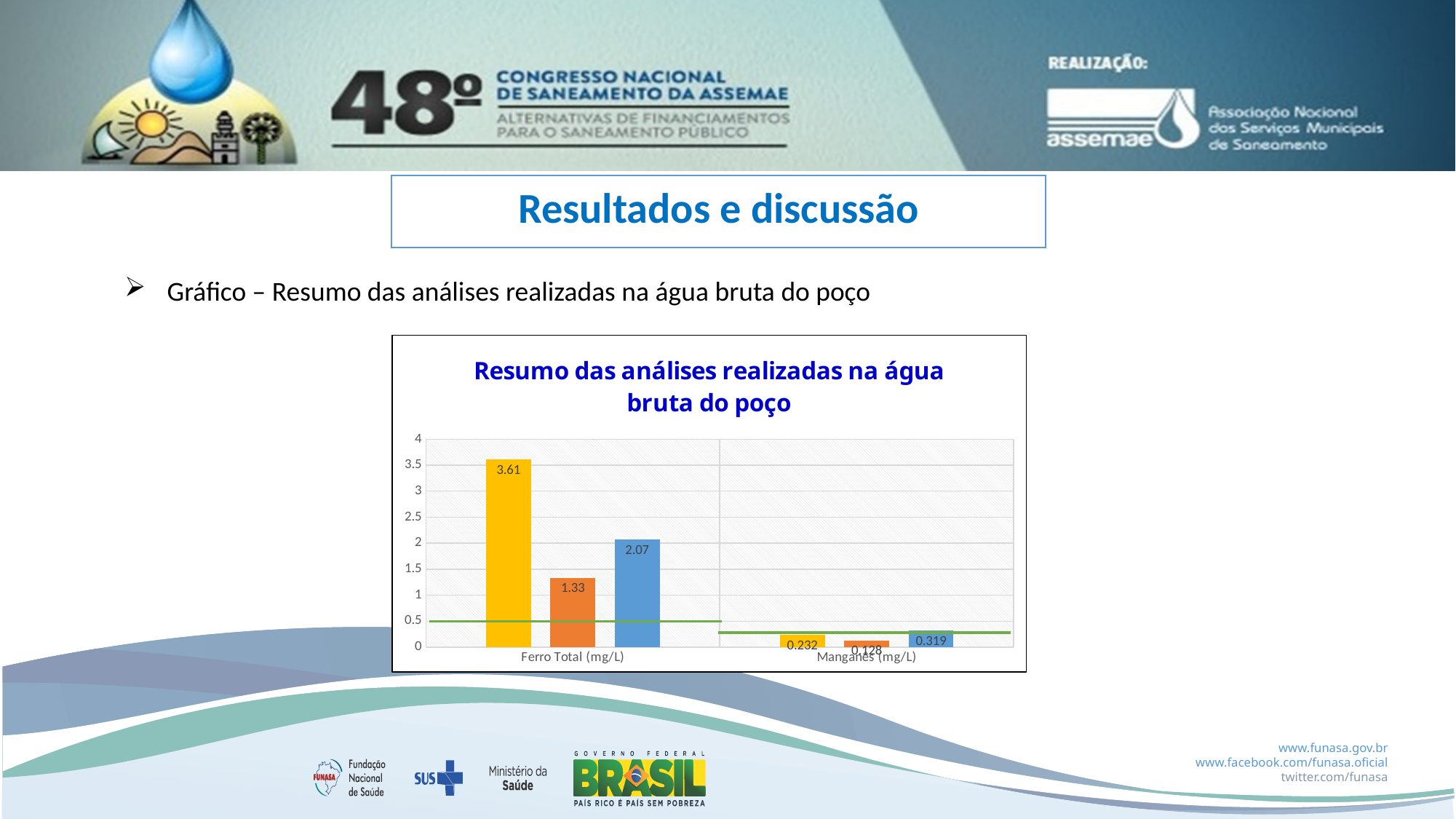
How many categories are shown on the x axis of the chart? 2 Which bar has the highest value in the Ferro Total (mg/L) category? The yellow bar (3.61) What is the value of the orange bar for Ferro Total (mg/L)? 1.33 What is the title of the chart? Resumo das análises realizadas na água bruta do poço What kind of chart is shown on the slide? Bar chart Which bar has the lowest value in the Manganês (mg/L) category? The orange bar (0.128) What is the value of the yellow bar for Ferro Total (mg/L)? 3.61 What is the value of the blue bar for Manganês (mg/L)? 0.319 What is the value of the yellow bar for Manganês (mg/L)? 0.232 What is the difference between the yellow bar and the blue bar for Ferro Total (mg/L)? 1.54 What is the value of the blue bar for Ferro Total (mg/L)? 2.07 Which is larger for Ferro Total (mg/L): the orange bar or the blue bar? The blue bar